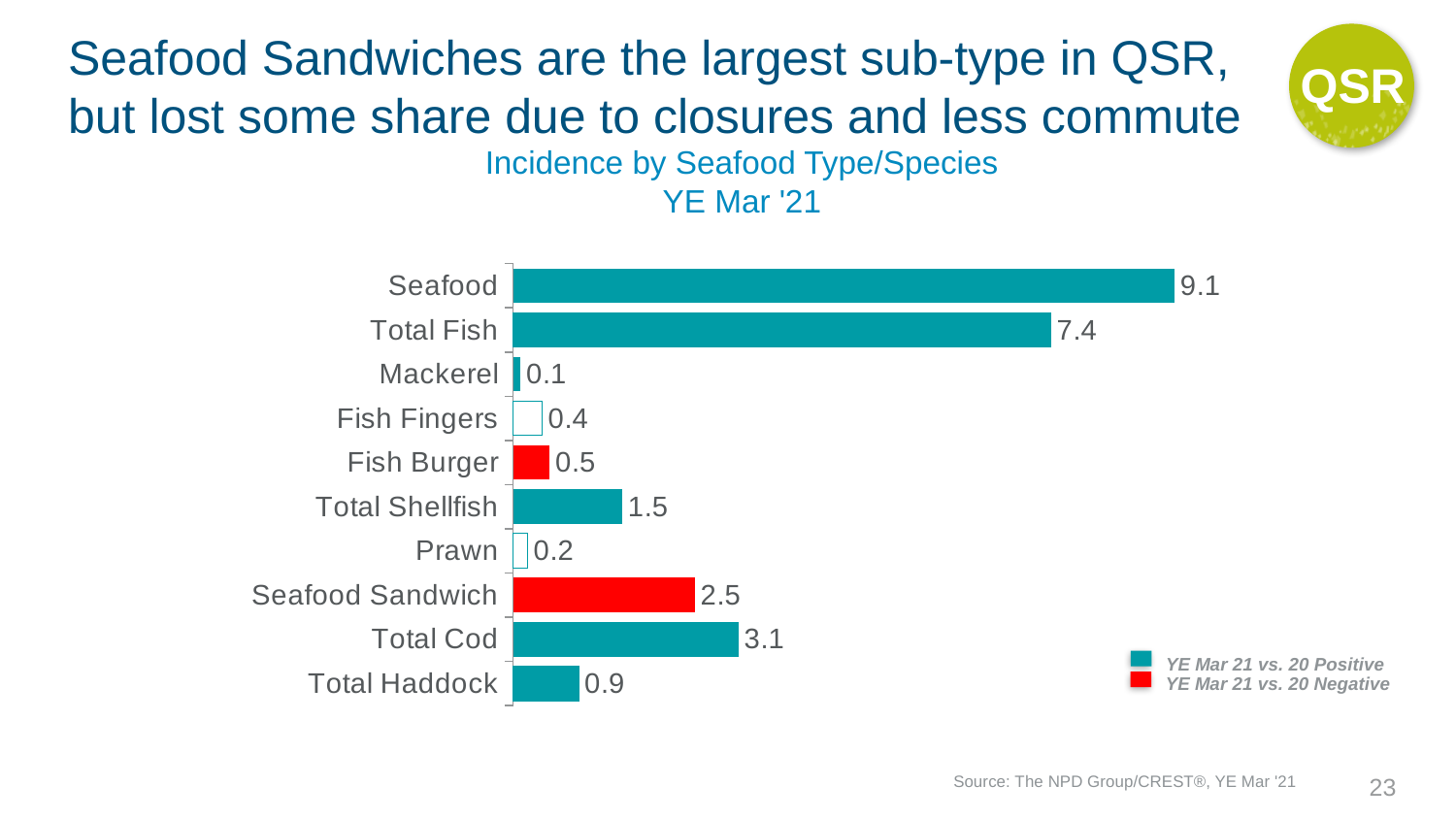
What is the incidence value for Seafood Sandwich? 2.5 According to the legend, what does a red bar indicate? YE Mar 21 vs. 20 Negative What is the title of the chart? Incidence by Seafood Type/Species YE Mar '21 What is the incidence value for Total Cod? 3.1 How many categories are shown on the chart? 10 Which is larger, the value for Total Cod or the value for Total Haddock? Total Cod What kind of chart is shown on the slide? Bar chart What is the difference between the values for Total Fish and Total Shellfish? 5.9 What is the incidence value for Seafood? 9.1 Which category has the highest incidence value? Seafood Which category has the lowest incidence value? Mackerel What is the difference between the values for Seafood and Total Fish? 1.7